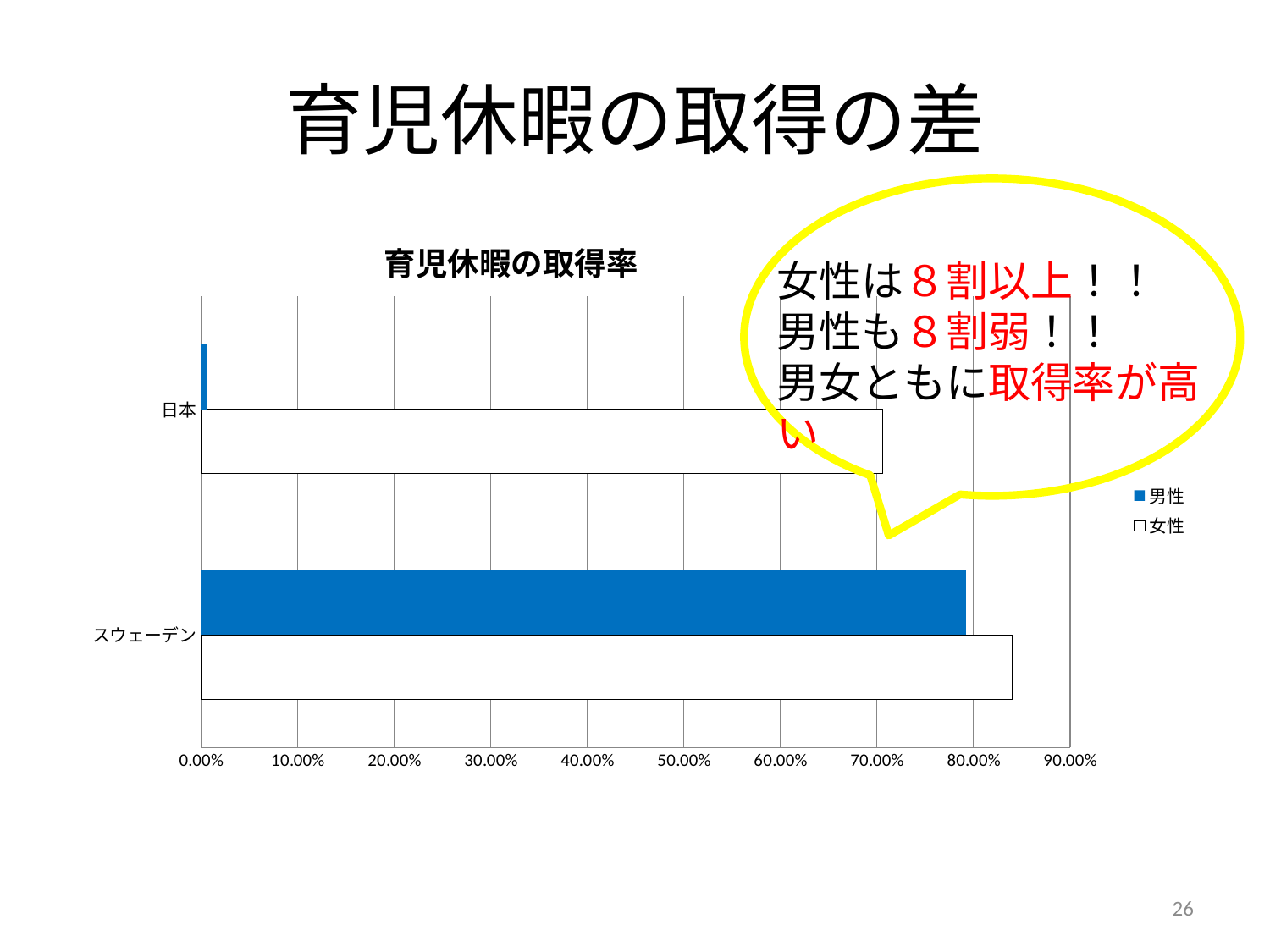
Which country has the higher 男性 value, 日本 or スウェーデン? スウェーデン What kind of chart is shown on the slide? bar chart Is the 男性 value for 日本 greater or less than 10.00%? less How many series does the legend list? 2 Which two series are listed in the legend? 男性 and 女性 Is the 男性 value for スウェーデン greater or less than 70.00%? greater Is the 女性 value for 日本 greater or less than 80.00%? less What is the title of the chart? 育児休暇の取得率 Which bar on the chart is the lowest? 男性 for 日本 How many countries (categories) are plotted on the chart? 2